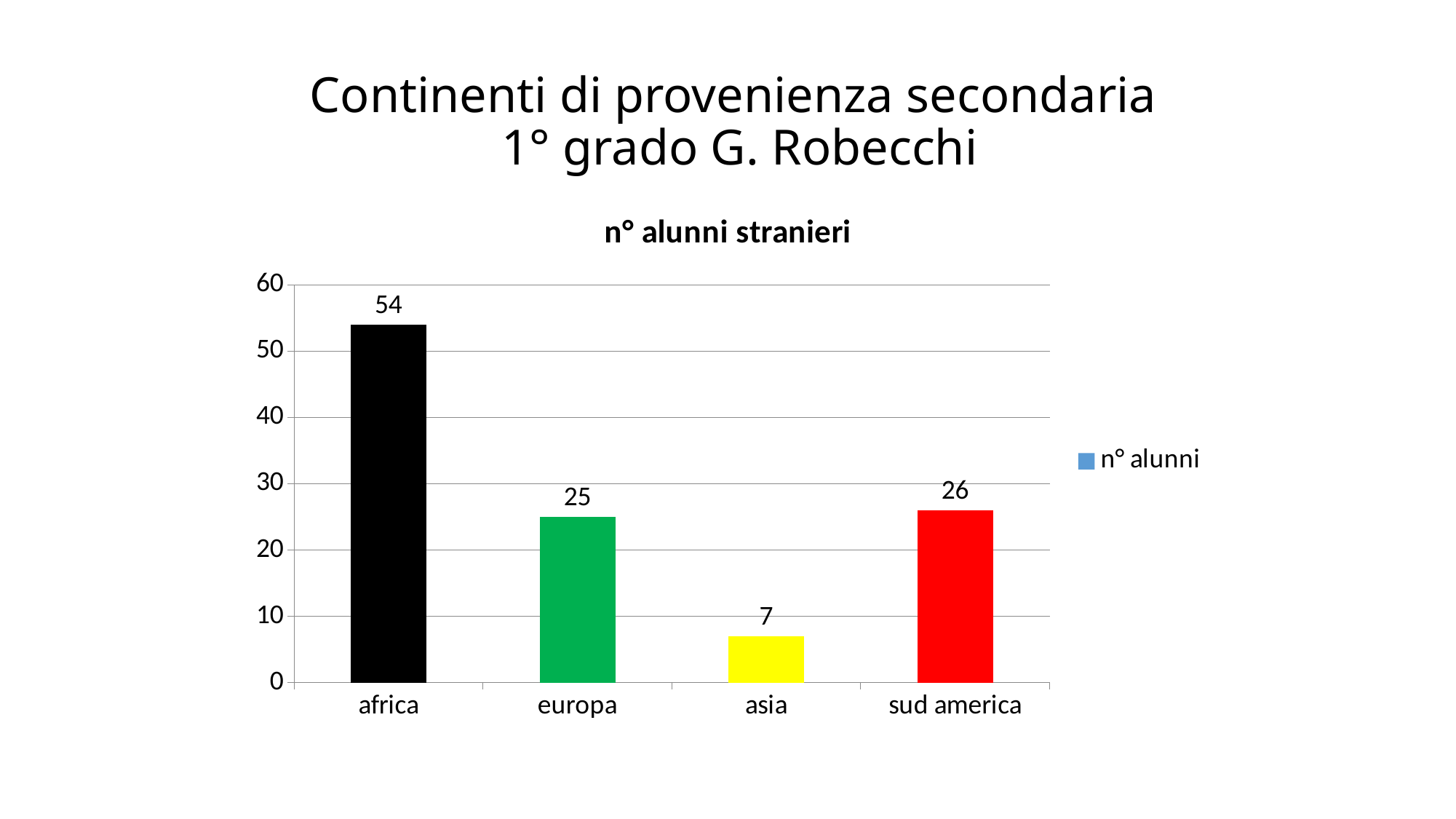
Is the value for asia greater or less than 10? less What is the value for asia? 7 Which category has the lowest value? asia What kind of chart is shown on the slide? bar chart What is the value for europa? 25 Which category has the highest value? africa How many categories are shown on the x axis? 4 What is the title of the chart? n° alunni stranieri What is the difference between the values for africa and sud america? 28 What is the value for africa? 54 Which is larger, the value for africa or the value for europa? africa What is the value for sud america? 26